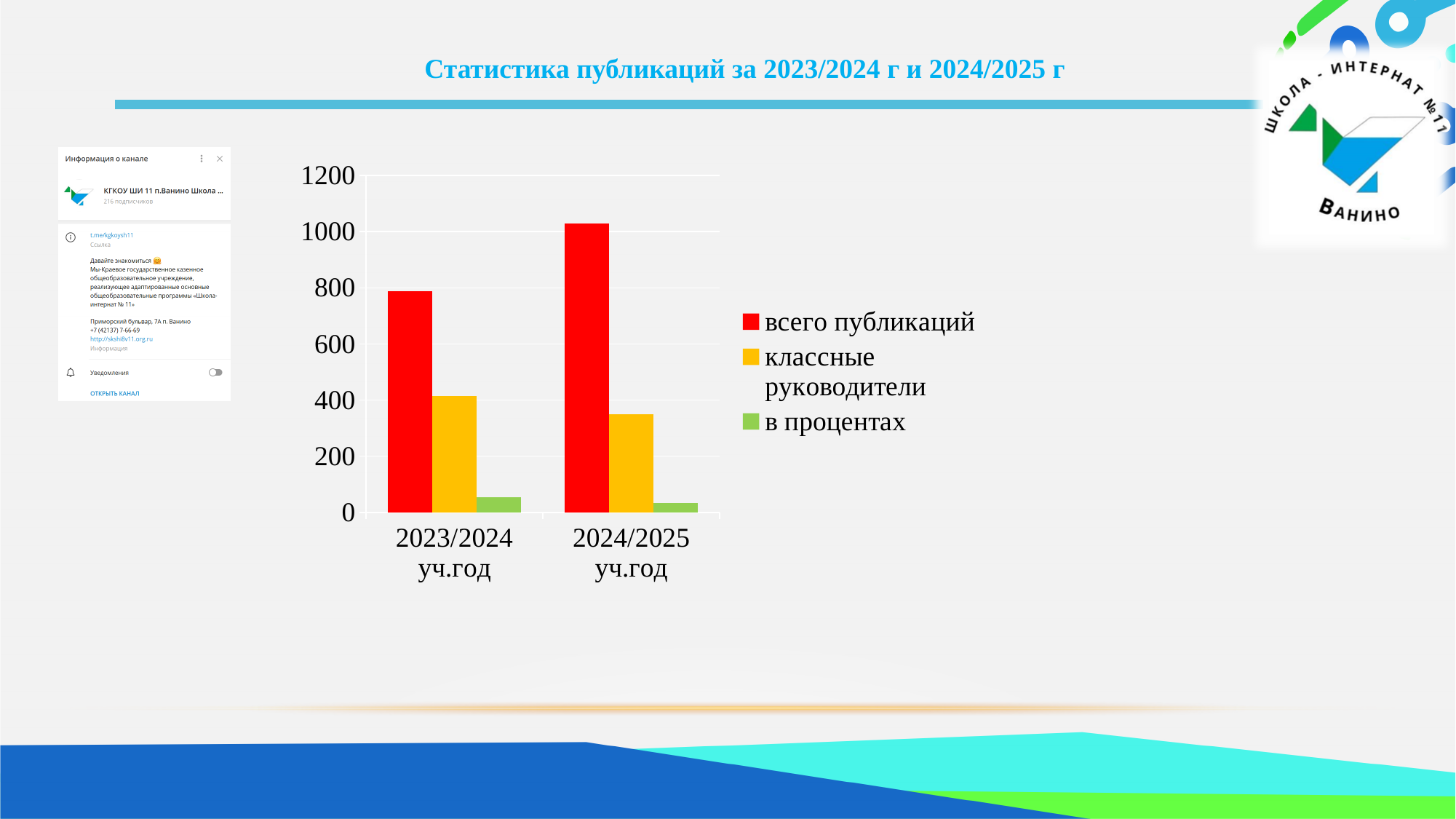
Is the value for "в процентах" in 2023/2024 уч.год greater or less than 200? less Which year has the larger value for "всего публикаций": 2023/2024 уч.год or 2024/2025 уч.год? 2024/2025 уч.год How many series does the chart legend list? 3 Does the value for "всего публикаций" rise or fall from 2023/2024 уч.год to 2024/2025 уч.год? rise Is the value for "всего публикаций" in 2024/2025 уч.год greater or less than 1000? greater What kind of chart is shown on the slide? bar chart Which year has the larger value for "классные руководители": 2023/2024 уч.год or 2024/2025 уч.год? 2023/2024 уч.год What is the title of the slide containing the chart? Статистика публикаций за 2023/2024 г и 2024/2025 г Is the value for "классные руководители" in 2024/2025 уч.год greater or less than 400? less How many categories are shown on the x axis of the chart? 2